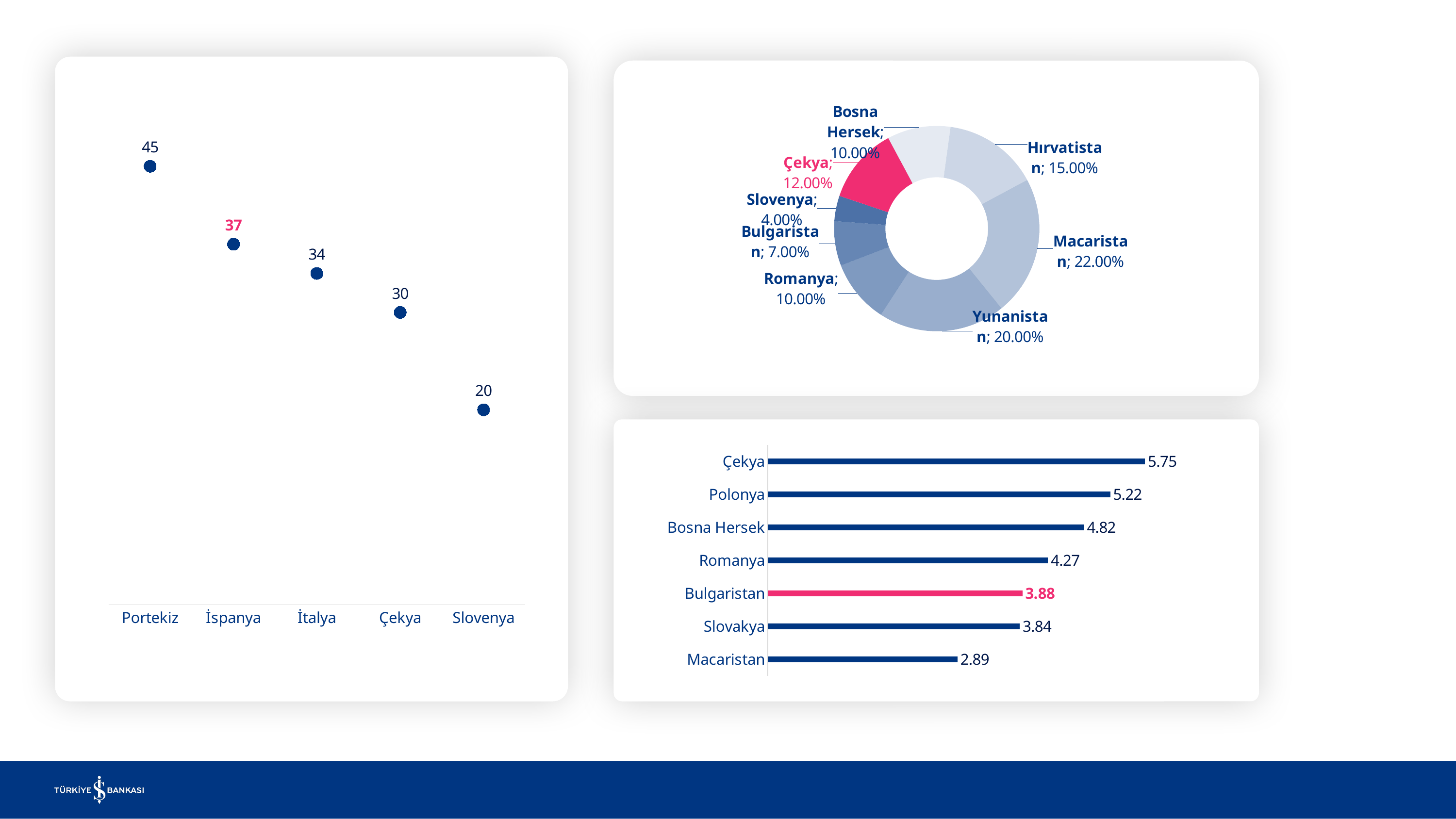
In the chart on the left of the slide, what is the difference between the values for İspanya and İtalya? 3 In the bar chart at the bottom right of the slide, what is the value for Polonya? 5.22 In the chart on the left of the slide, which category has the lowest value? Slovenya In the donut chart at the top right of the slide, which slice is highlighted in pink? Çekya In the donut chart at the top right of the slide, how many slices are there? 8 In the bar chart at the bottom right of the slide, which category has the highest value? Çekya In the donut chart at the top right of the slide, which slice is the smallest? Slovenya In the chart on the left of the slide, what is the value for Portekiz? 45 In the bar chart at the bottom right of the slide, what is the difference between the values for Çekya and Macaristan? 2.86 In the donut chart at the top right of the slide, what share does Macaristan have? 22.00% In the chart on the left of the slide, do the values rise or fall from Portekiz to Slovenya? fall In the chart on the left of the slide, how many categories are plotted? 5